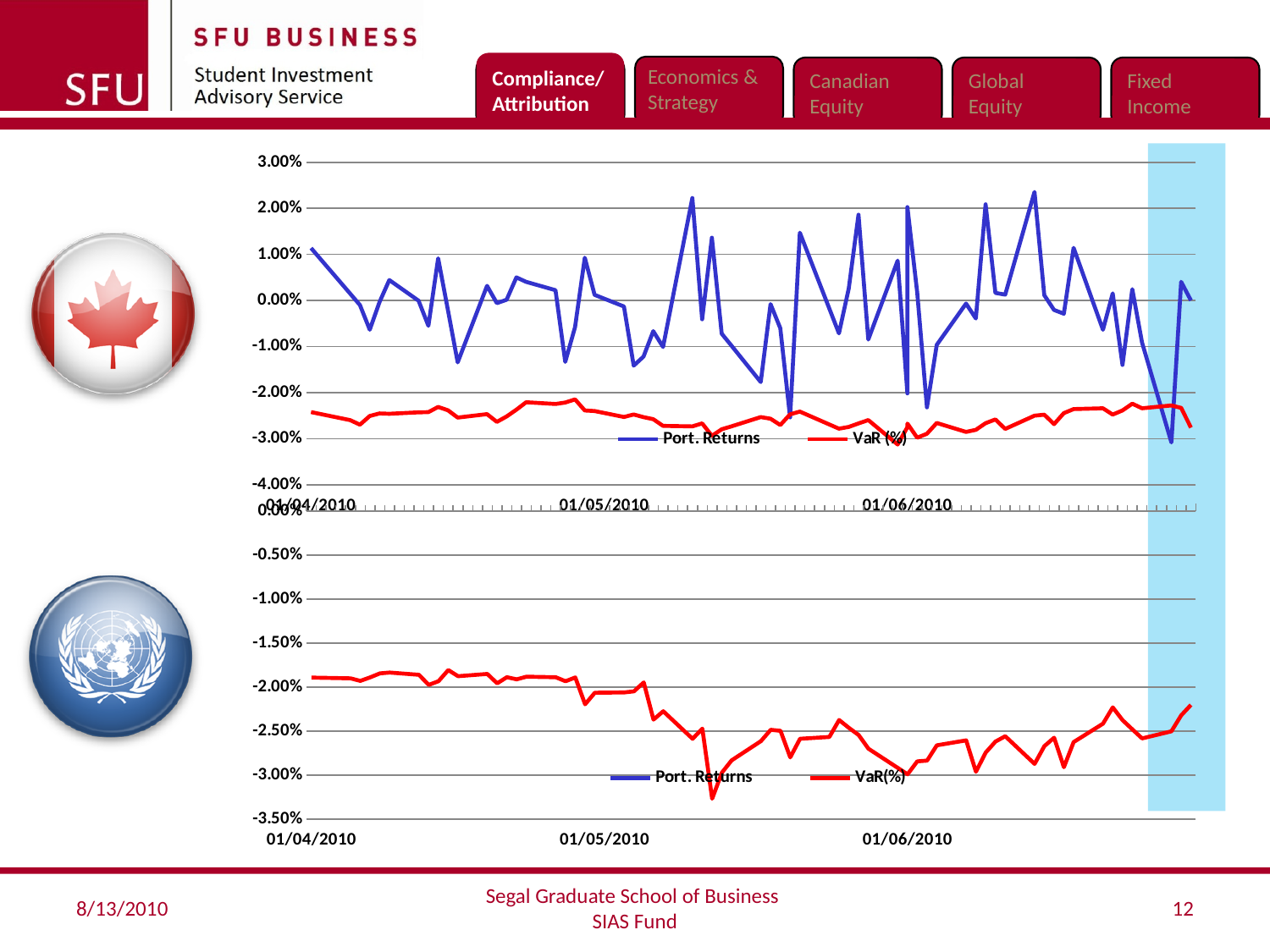
What kind of chart is the top chart on the slide? line chart How many series does the legend of the top chart list? 2 In the bottom chart, is the VaR(%) value at 01/06/2010 greater or less than -2.00%? less In the top chart, is the Port. Returns value at 01/04/2010 greater or less than 0.00%? greater What kind of chart is the bottom chart on the slide? line chart What is the first date label shown on the x axis of the bottom chart? 01/04/2010 What are the two series named in the legend of the top chart? Port. Returns and VaR (%) How many series does the legend of the bottom chart list? 2 In the bottom chart, does the VaR(%) line rise or fall between 01/04/2010 and 01/06/2010? fall In the top chart, is the VaR(%) value at 01/05/2010 greater or less than -2.00%? less In the top chart, which series has the higher value at 01/04/2010, Port. Returns or VaR(%)? Port. Returns